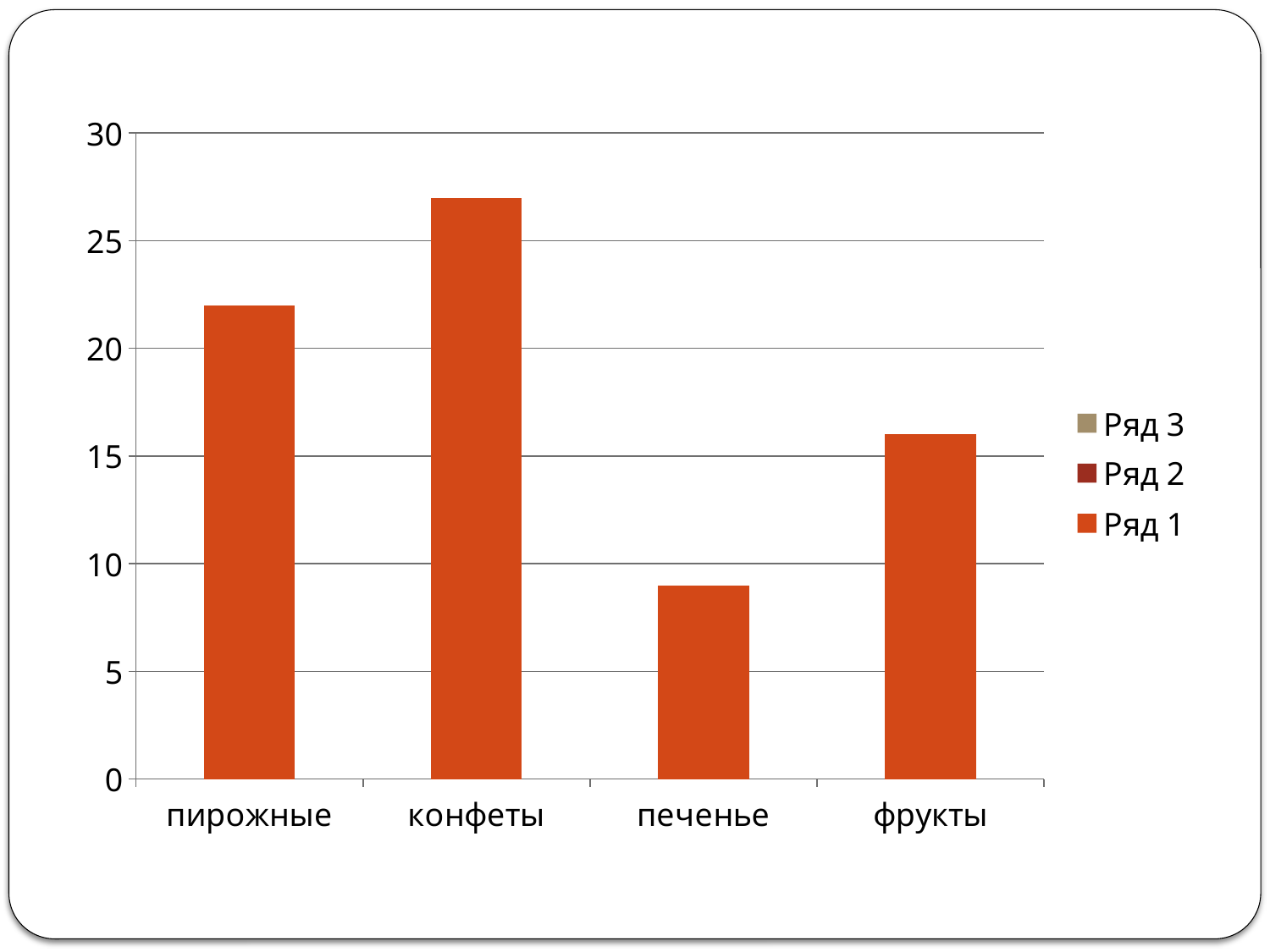
What kind of chart is shown on the slide? bar chart How many categories are shown on the x axis? 4 Which is larger, the value for печенье or the value for фрукты? фрукты Is the value for пирожные greater or less than 20? greater Which category has the lowest bar? печенье Is the value for печенье greater or less than 10? less Is the value for фрукты greater or less than 15? greater What is the name of the series plotted in orange according to the legend? Ряд 1 Which is larger, the value for пирожные or the value for фрукты? пирожные How many series does the legend list? 3 Which category has the highest bar? конфеты